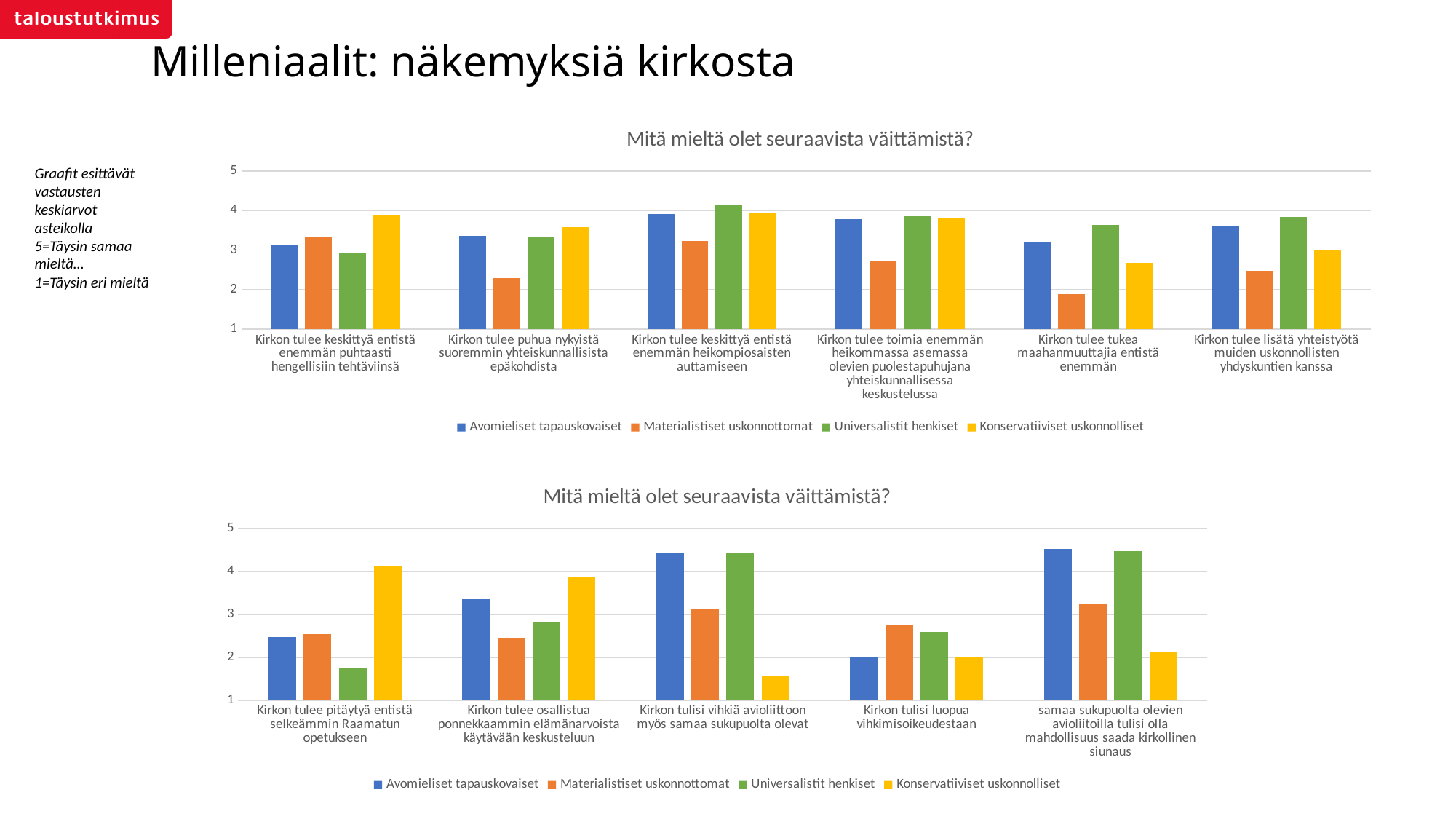
In the top chart, is the value for Universalistit henkiset on 'Kirkon tulee keskittyä entistä enemmän heikompiosaisten auttamiseen' greater or less than 4? greater What type of chart is the top chart on the slide? bar chart In the top chart, which group has the highest value for 'Kirkon tulee keskittyä entistä enemmän puhtaasti hengellisiin tehtäviinsä'? Konservatiiviset uskonnolliset How many statement categories are shown on the x axis of the bottom chart? 5 In the top chart, which group has the lowest value for 'Kirkon tulee puhua nykyistä suoremmin yhteiskunnallisista epäkohdista'? Materialistiset uskonnottomat How many series does the legend of the top chart list? 4 In the top chart, is the value for Materialistiset uskonnottomat on 'Kirkon tulee tukea maahanmuuttajia entistä enemmän' greater or less than 2? less In the bottom chart, is the value for Konservatiiviset uskonnolliset on 'Kirkon tulisi vihkiä avioliittoon myös samaa sukupuolta olevat' greater or less than 2? less How many statement categories are shown on the x axis of the top chart? 6 In the bottom chart, which group has the highest value for 'Kirkon tulisi luopua vihkimisoikeudestaan'? Materialistiset uskonnottomat In the bottom chart, for 'Kirkon tulee osallistua ponnekkaammin elämänarvoista käytävään keskusteluun', which is larger: the value for Konservatiiviset uskonnolliset or for Materialistiset uskonnottomat? Konservatiiviset uskonnolliset In the bottom chart, which group has the lowest value for 'Kirkon tulee pitäytyä entistä selkeämmin Raamatun opetukseen'? Universalistit henkiset